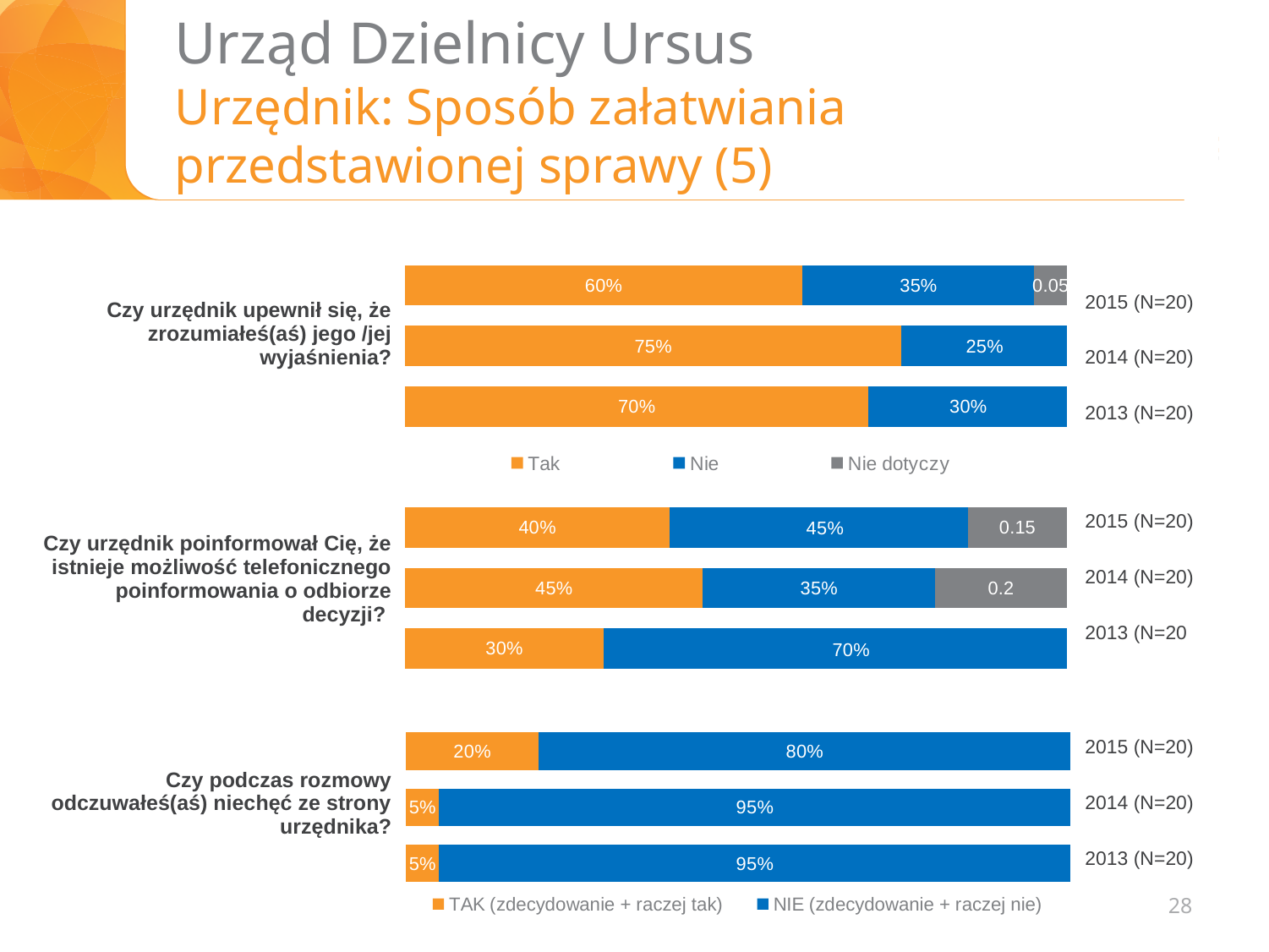
In the middle chart (Czy urzędnik poinformował Cię...), what is the Nie dotyczy value for 2014 (N=20)? 0.2 In the middle chart (Czy urzędnik poinformował Cię, że istnieje możliwość telefonicznego poinformowania o odbiorze decyzji?), what is the Nie value for 2013? 70% In the top chart (Czy urzędnik upewnił się...), which year has the highest Tak value? 2014 (N=20) In the middle chart (Czy urzędnik poinformował Cię...), which year has the lowest Tak value? 2013 In the bottom chart (Czy podczas rozmowy odczuwałeś(aś) niechęć ze strony urzędnika?), what is the NIE value for 2015 (N=20)? 80% In the top chart (Czy urzędnik upewnił się...), what is the Nie value for 2014 (N=20)? 25% In the middle chart (Czy urzędnik poinformował Cię...), is the Tak value for 2015 larger or smaller than the Nie value for 2015? smaller In the top chart (Czy urzędnik upewnił się, że zrozumiałeś(aś) jego /jej wyjaśnienia?), what is the Tak value for 2015 (N=20)? 60% In the top chart (Czy urzędnik upewnił się...), what is the difference between the Tak values for 2014 and 2013? 5% How many series does the legend of the top chart (Czy urzędnik upewnił się...) list? 3 What type of chart is used on this slide? Stacked bar chart In the bottom chart (Czy podczas rozmowy odczuwałeś(aś) niechęć...), what is the TAK value for 2015 (N=20)? 20%